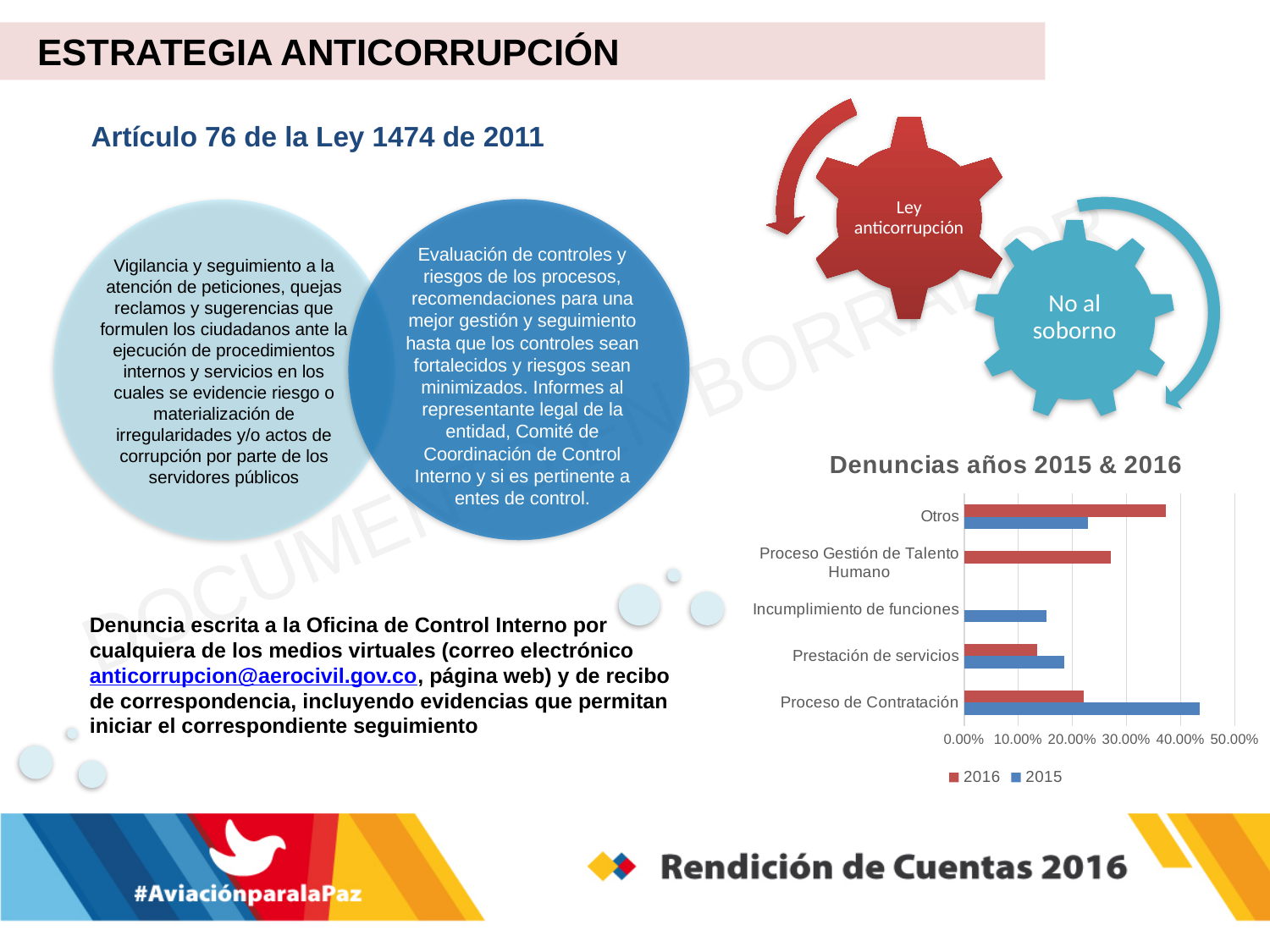
In the "Denuncias años 2015 & 2016" chart, is the 2016 value for Otros greater or less than 30.00%? greater In the "Denuncias años 2015 & 2016" chart, which category has the highest value for 2016? Otros In the "Denuncias años 2015 & 2016" chart, is the 2015 value for Proceso de Contratación greater or less than 40.00%? greater What is the title of the bar chart on the slide? Denuncias años 2015 & 2016 In the "Denuncias años 2015 & 2016" chart, which series is shown in blue? 2015 In the "Denuncias años 2015 & 2016" chart, is the 2015 value for Incumplimiento de funciones greater or less than 20.00%? less In the "Denuncias años 2015 & 2016" chart, which is larger for Proceso de Contratación, the 2015 value or the 2016 value? 2015 In the "Denuncias años 2015 & 2016" chart, which category has the highest value for 2015? Proceso de Contratación What kind of chart is shown under the title "Denuncias años 2015 & 2016"? bar chart How many series does the legend of the "Denuncias años 2015 & 2016" chart list? 2 How many categories are shown on the "Denuncias años 2015 & 2016" chart? 5 In the "Denuncias años 2015 & 2016" chart, which is larger for Otros, the 2015 value or the 2016 value? 2016